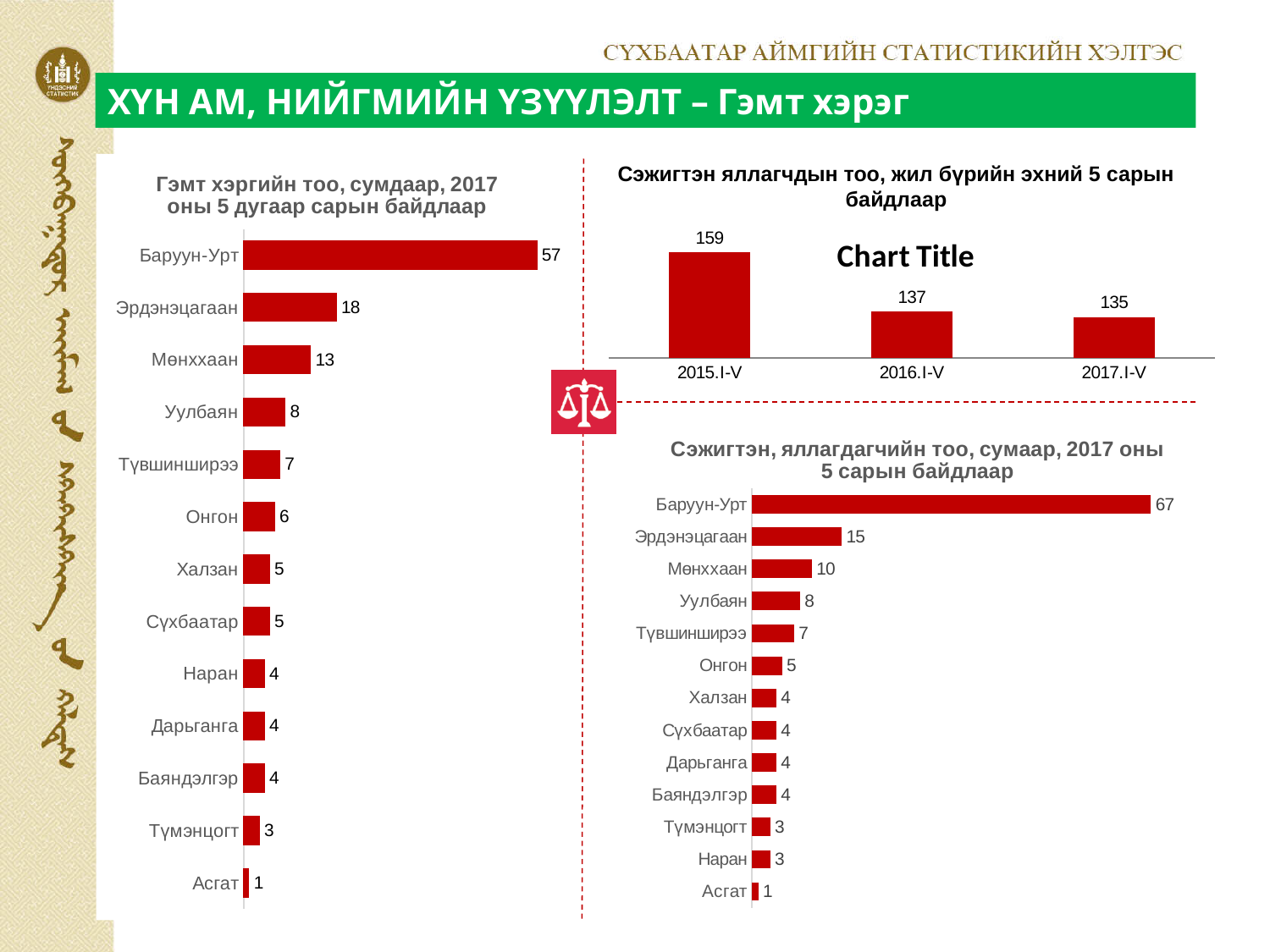
In the bottom-right chart 'Сэжигтэн, яллагдагчийн тоо, сумаар, 2017 оны 5 сарын байдлаар', what is the value for Баруун-Урт? 67 How many sums are shown in the left chart 'Гэмт хэргийн тоо, сумдаар'? 13 In the top-right chart 'Сэжигтэн яллагчдын тоо', what is the difference between 2015.I-V and 2017.I-V? 24 In the left chart 'Гэмт хэргийн тоо, сумдаар', what is the difference between Эрдэнэцагаан and Мөнххаан? 5 In the top-right chart 'Сэжигтэн яллагчдын тоо, жил бүрийн эхний 5 сарын байдлаар', what is the value for 2016.I-V? 137 In the top-right chart 'Сэжигтэн яллагчдын тоо', which period has the highest value? 2015.I-V In the top-right chart 'Сэжигтэн яллагчдын тоо', do the values rise or fall from 2015.I-V to 2017.I-V? fall In the left chart 'Гэмт хэргийн тоо, сумдаар, 2017 оны 5 дугаар сарын байдлаар', what is the value for Баруун-Урт? 57 In the left chart 'Гэмт хэргийн тоо, сумдаар', which sum has the lowest value? Асгат What kind of chart is the top-right chart 'Сэжигтэн яллагчдын тоо'? bar chart In the bottom-right chart 'Сэжигтэн, яллагдагчийн тоо, сумаар', which is larger, Эрдэнэцагаан or Мөнххаан? Эрдэнэцагаан In the bottom-right chart 'Сэжигтэн, яллагдагчийн тоо, сумаар', what is the value for Түмэнцогт? 3